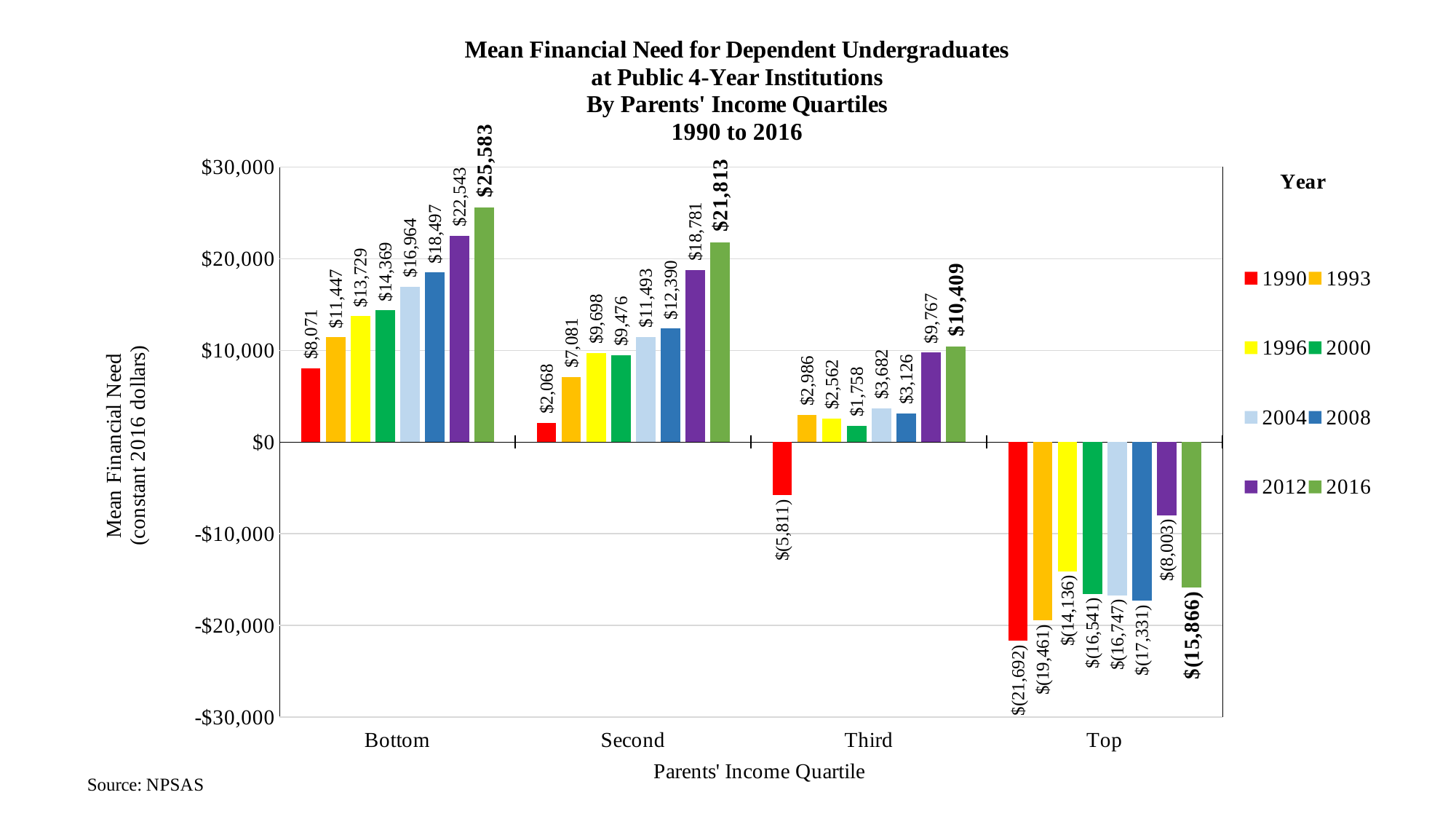
How many years does the legend list? 8 Which income quartile has the highest mean financial need in 2016? Bottom What is the mean financial need for the Second income quartile in 1993? $7,081 What is the mean financial need for the Top income quartile in 1990? $(21,692) Which year has the lowest mean financial need for the Bottom income quartile? 1990 What kind of chart is shown on the slide? Bar chart What is the mean financial need for the Third income quartile in 2004? $3,682 What is the difference between the 2016 and 1990 mean financial need for the Bottom income quartile? $17,512 How many income quartile categories are shown on the x axis? 4 What is the source cited for the chart data? NPSAS Which is larger for the Second income quartile: the 1996 value or the 2000 value? 1996 What is the mean financial need for the Bottom income quartile in 2016? $25,583